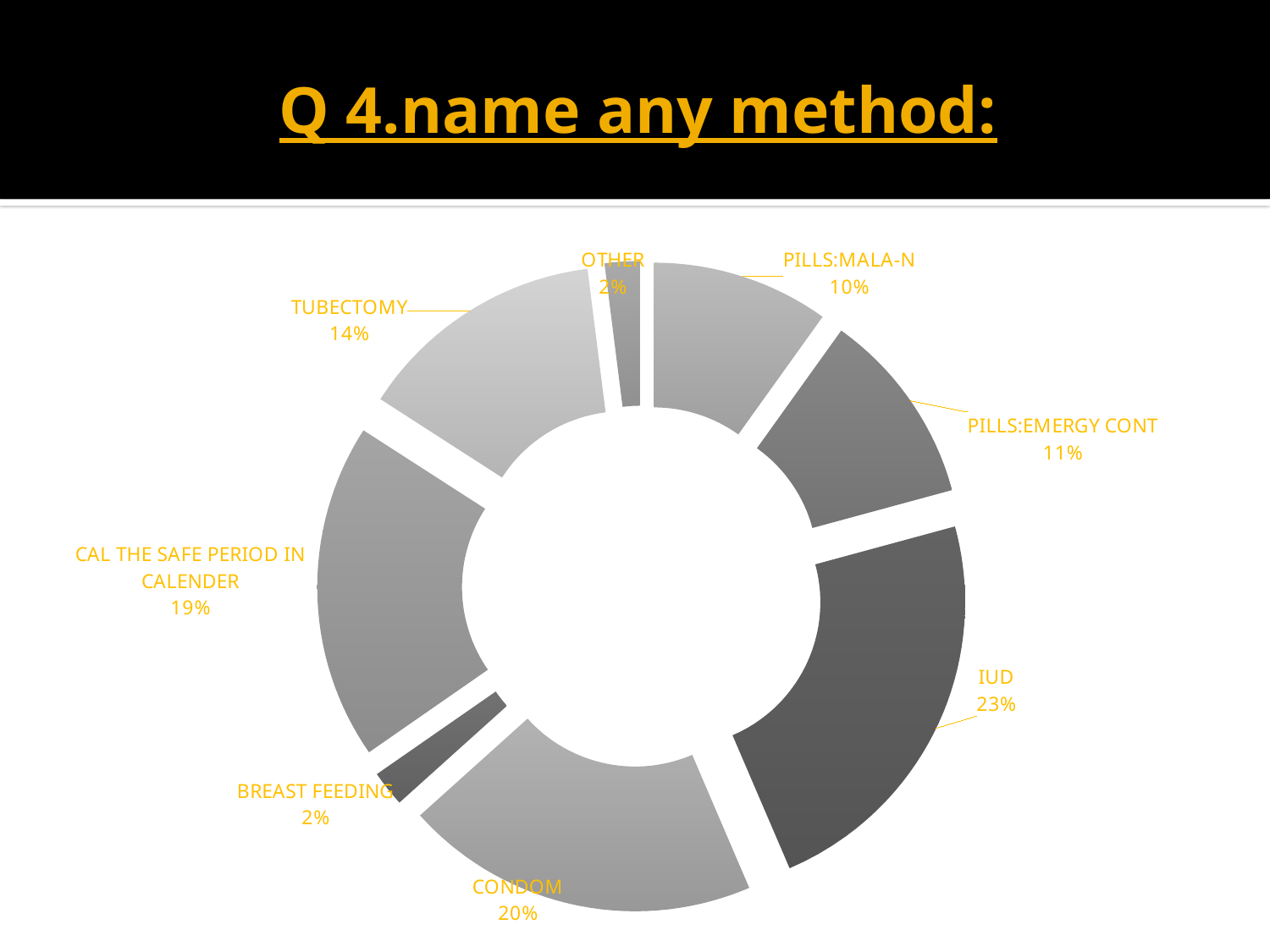
What percentage is shown for PILLS:EMERGY CONT? 11% Which method has the largest share in the chart? IUD What percentage of the chart is labelled IUD? 23% What kind of chart is shown on the slide? doughnut chart Which is larger, the share for TUBECTOMY or the share for PILLS:MALA-N? TUBECTOMY What is the difference in percentage points between PILLS:EMERGY CONT and PILLS:MALA-N? 1 What is the value for CAL THE SAFE PERIOD IN CALENDER? 19% What is the value shown for TUBECTOMY? 14% How many categories are shown in the chart? 8 What is the title of the slide? Q 4.name any method: What share does CONDOM have in the chart? 20% What is the difference in percentage points between IUD and CONDOM? 3